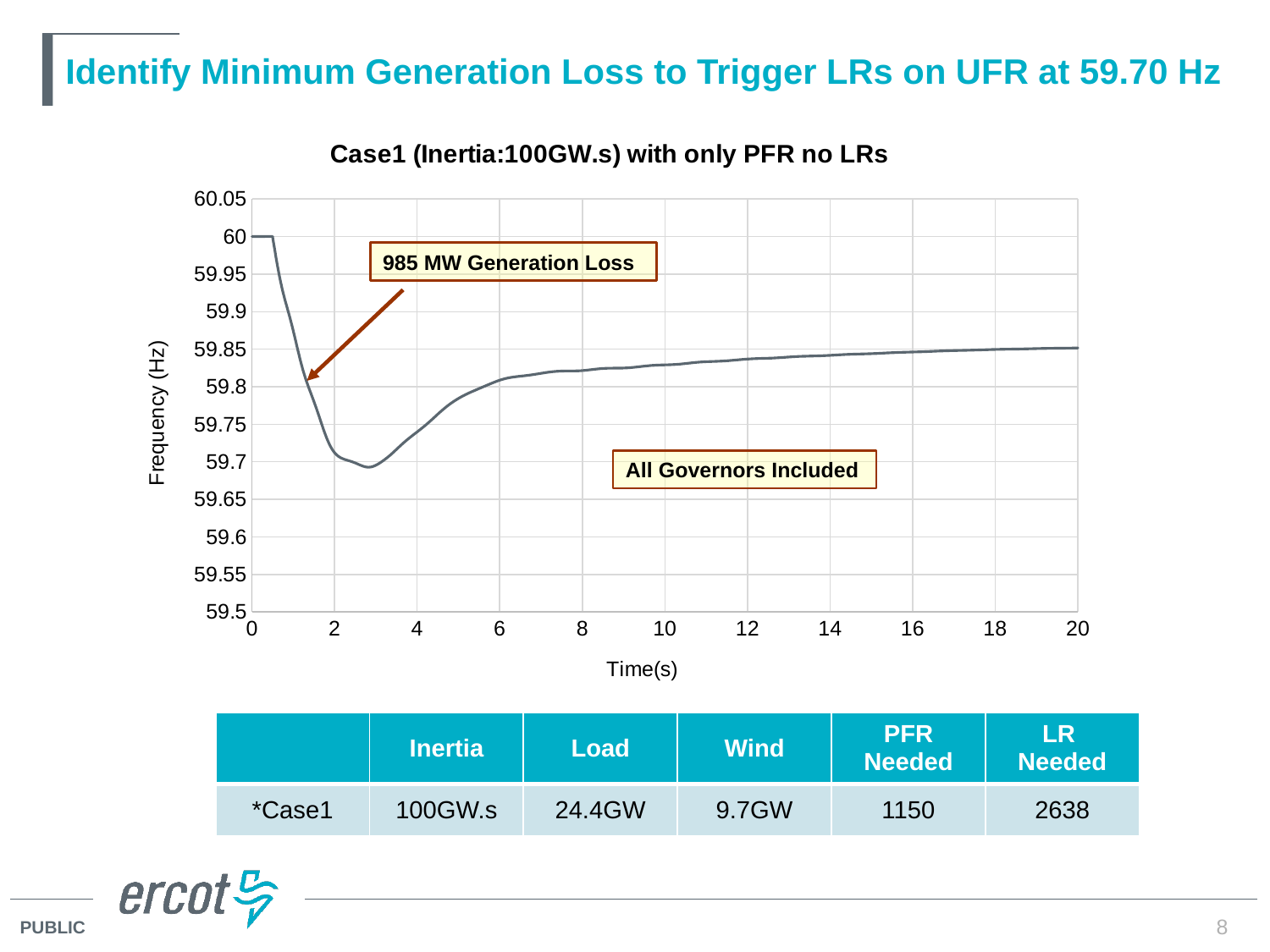
Is the frequency at time 6 s greater or less than 59.85 Hz? less What is the maximum value shown on the x axis of the chart? 20 What is the label of the y axis of the chart? Frequency (Hz) What is the frequency value at time 0 s on the chart? 60 How does the frequency change between time 4 s and time 20 s? it rises Is the frequency at time 20 s greater or less than 59.8 Hz? greater What kind of chart is shown on the slide? line chart Is the frequency at time 2 s greater or less than 59.75 Hz? less Which is larger, the frequency at time 3 s or the frequency at time 15 s? time 15 s What is the title of the chart? Case1 (Inertia:100GW.s) with only PFR no LRs